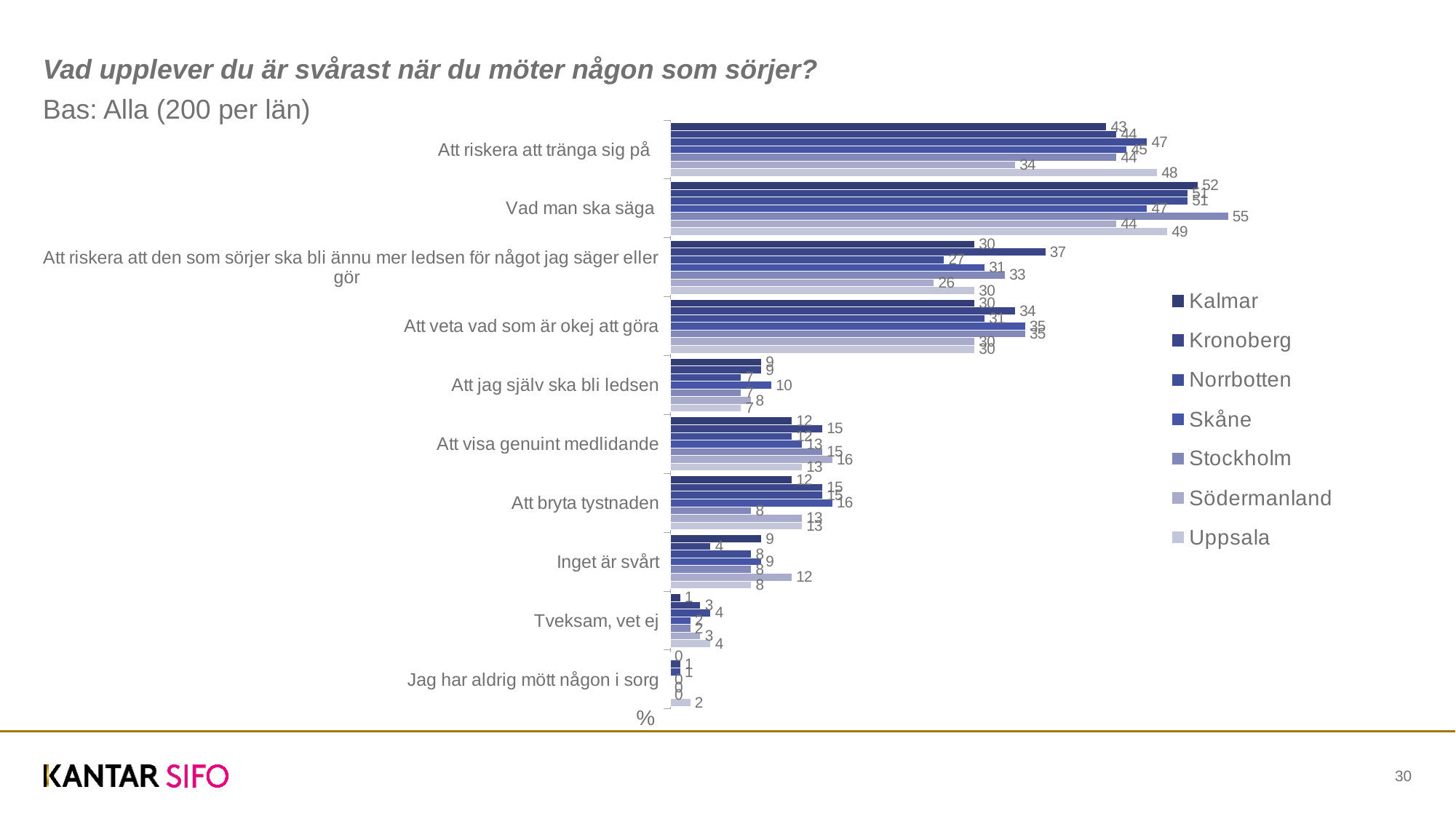
What is the value for Stockholm in the category 'Vad man ska säga'? 55 How many categories (answer options) are shown on the chart? 10 What is the value for Kronoberg in the category 'Att riskera att den som sörjer ska bli ännu mer ledsen för något jag säger eller gör'? 37 In the category 'Att riskera att den som sörjer ska bli ännu mer ledsen för något jag säger eller gör', which is larger: Kronoberg or Södermanland? Kronoberg How many series (counties) does the legend list? 7 What is the value for Södermanland in the category 'Att riskera att tränga sig på'? 34 Which county has the lowest value in the category 'Att riskera att tränga sig på'? Södermanland Which county is listed first in the legend? Kalmar Which county has the highest value in the category 'Vad man ska säga'? Stockholm What kind of chart is shown on the slide? bar chart What is the value for Stockholm in the category 'Att bryta tystnaden'? 8 In the category 'Att riskera att tränga sig på', what is the difference between the values for Uppsala and Södermanland? 14